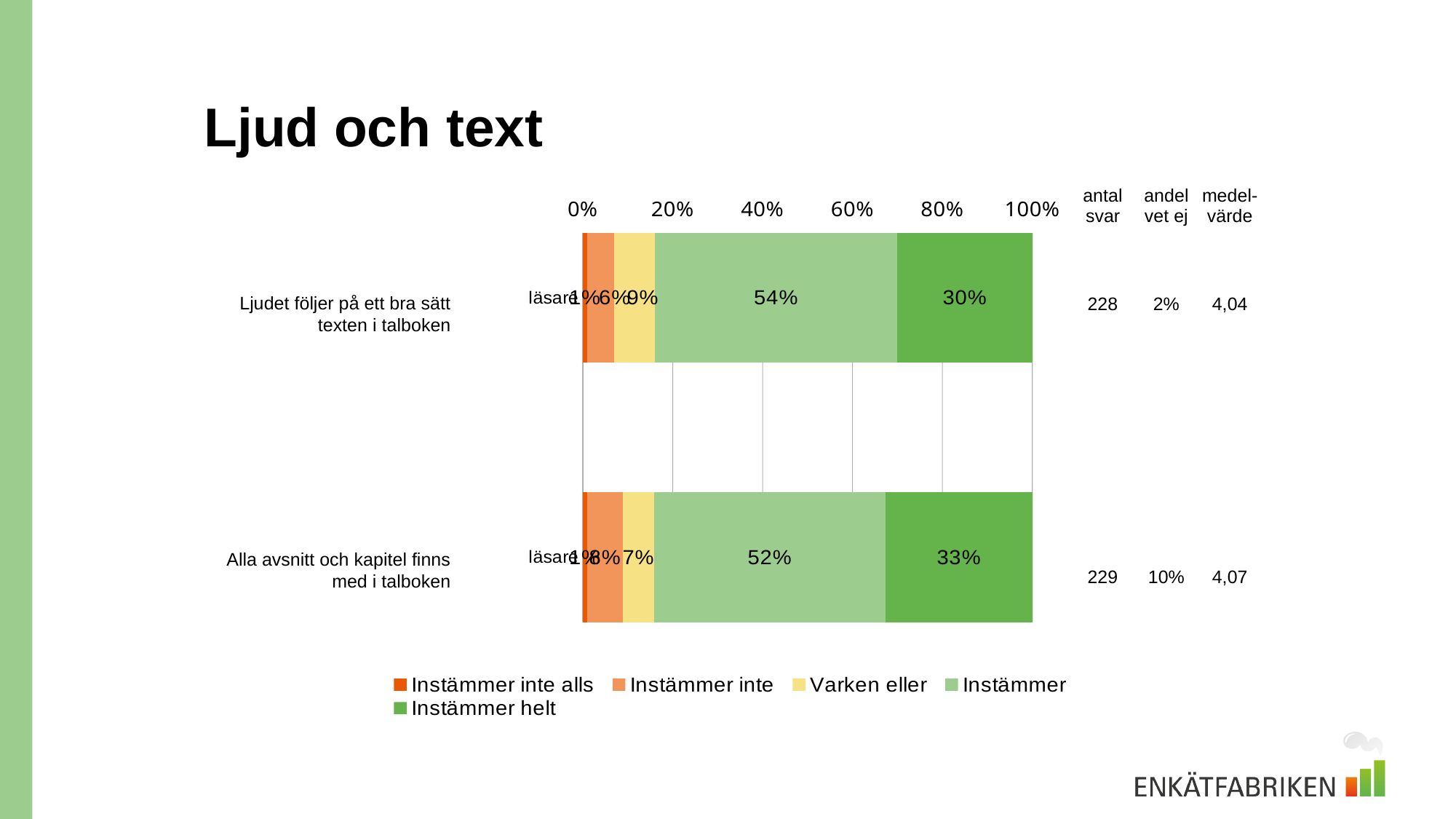
How many series does the legend list? 5 What is the difference between the 'Instämmer' shares of the two statements? 2% What is the 'Instämmer' share for 'Alla avsnitt och kapitel finns med i talboken'? 52% What is the 'Instämmer' share for 'Ljudet följer på ett bra sätt texten i talboken'? 54% How many statements (categories) are plotted in the chart? 2 What is the 'Instämmer helt' share for 'Ljudet följer på ett bra sätt texten i talboken'? 30% What is the 'medelvärde' for 'Ljudet följer på ett bra sätt texten i talboken'? 4,04 Which statement has the larger 'Instämmer helt' share? Alla avsnitt och kapitel finns med i talboken What is the 'antal svar' value for 'Alla avsnitt och kapitel finns med i talboken'? 229 What kind of chart is shown on the slide? bar chart What is the 'Instämmer helt' share for 'Alla avsnitt och kapitel finns med i talboken'? 33% What is the title of the slide? Ljud och text